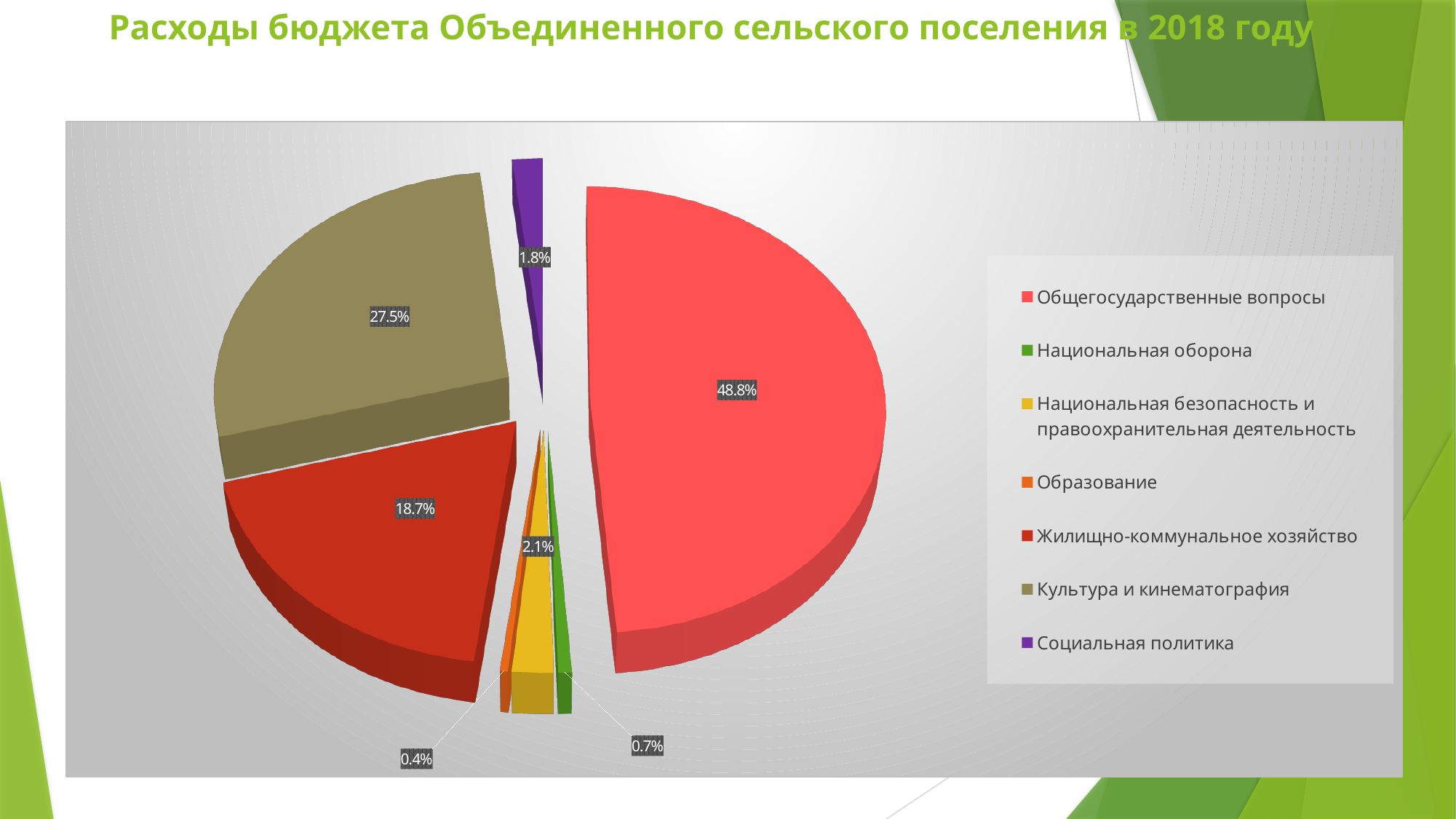
What share of the pie does Культура и кинематография have? 27.5% What share of the pie does Национальная безопасность и правоохранительная деятельность have? 2.1% Which category has the largest share of the pie? Общегосударственные вопросы What share of the pie does Образование have? 0.4% How many categories does the legend list? 7 What share of the pie does Социальная политика have? 1.8% What kind of chart is shown on the slide? Pie chart Which is larger, the share for Национальная оборона or the share for Социальная политика? Социальная политика What share of the pie does Жилищно-коммунальное хозяйство have? 18.7% What is the difference in percentage points between Культура и кинематография and Жилищно-коммунальное хозяйство? 8.8 Which category has the smallest share of the pie? Образование What share of the pie does Общегосударственные вопросы have? 48.8%